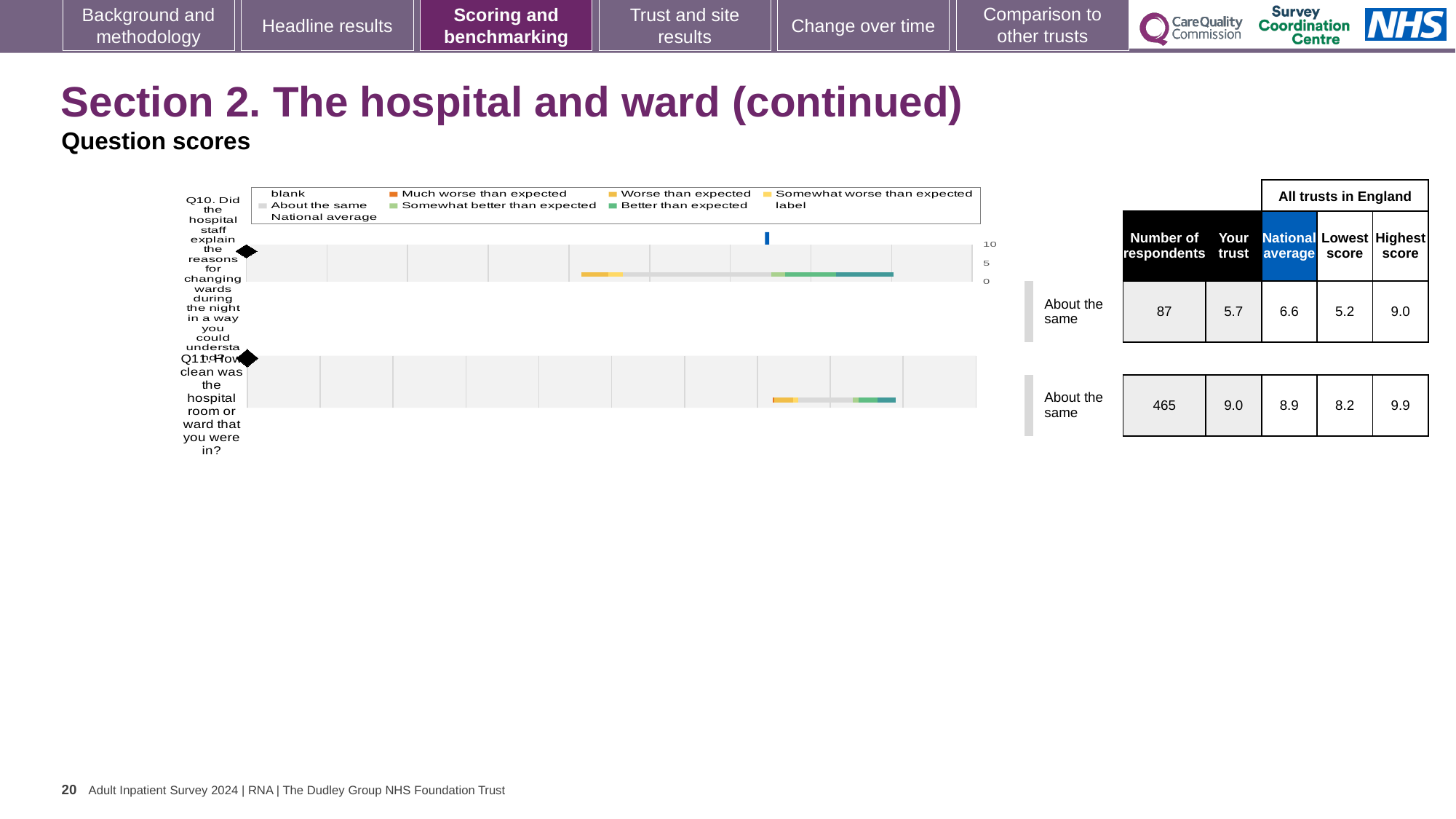
On the Q10 chart, what is the National average score? 6.6 How many question charts are shown on the slide? 2 Which question chart shows the higher Your trust score, Q10 or Q11? Q11 On the Q11 chart, what is the difference between the Highest score and the Lowest score? 1.7 On the Q10 chart (explaining reasons for changing wards during the night), what is the score for Your trust? 5.7 What benchmark category is the Q11 chart labelled with? About the same On the Q10 chart, which is larger: the Your trust score or the National average? National average On the Q11 chart (how clean was the hospital room or ward), what is the score for Your trust? 9.0 On the Q10 chart, how much higher is the National average than the Your trust score? 0.9 What kind of chart is used to show the question scores on this slide? Bar chart On the Q10 chart, what is the Lowest score among all trusts in England? 5.2 On the Q11 chart, how many respondents answered the question? 465